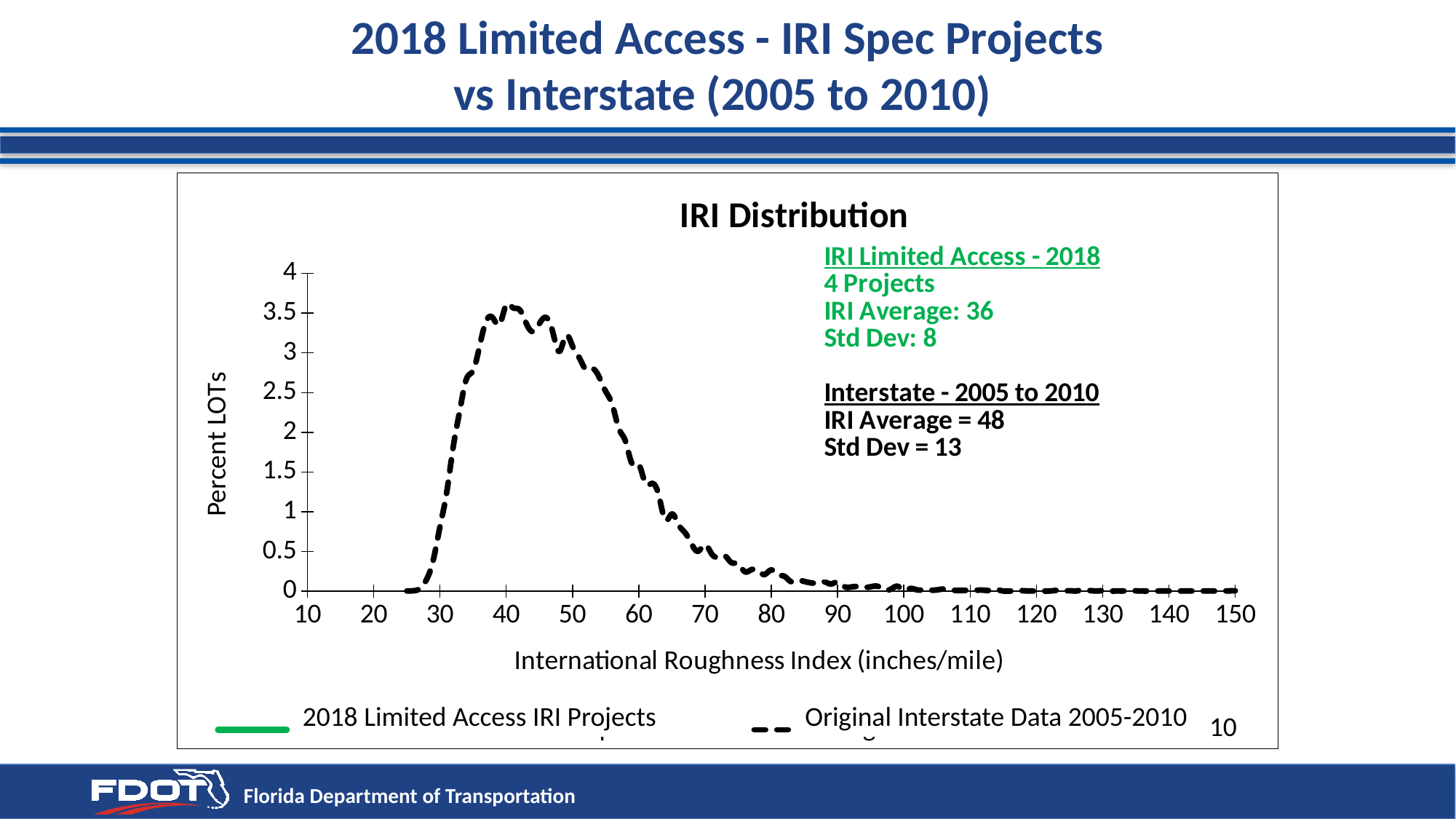
What is the title of the chart? IRI Distribution Is the value of the Original Interstate Data 2005-2010 line at an IRI of 80 greater or less than 0.5? less According to the annotation on the chart, what is the IRI Average for IRI Limited Access - 2018? 36 How many series does the chart legend list? 2 According to the annotation on the chart, what is the Std Dev for IRI Limited Access - 2018? 8 According to the annotation on the chart, what is the IRI Average for Interstate - 2005 to 2010? 48 Is the value of the Original Interstate Data 2005-2010 line at an IRI of 40 greater or less than 3? greater According to the annotation on the chart, what is the Std Dev for Interstate - 2005 to 2010? 13 How many projects are included in the IRI Limited Access - 2018 data, according to the chart annotation? 4 Projects What is the label of the y axis? Percent LOTs Does the Original Interstate Data 2005-2010 line rise or fall as the IRI increases from 50 to 100? fall What kind of chart is shown on the slide? line chart